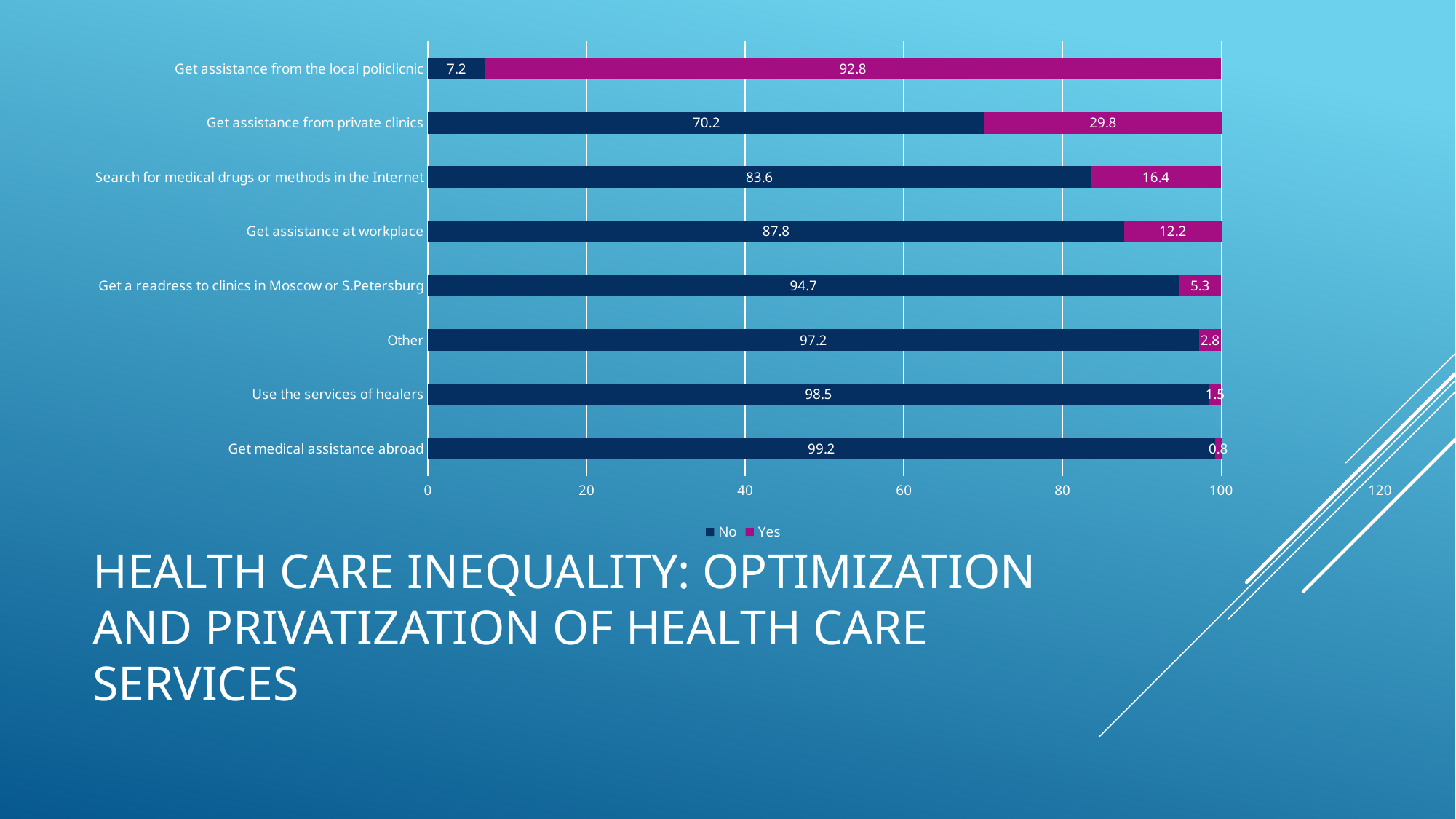
What is the total of the stacked bar for 'Other'? 100 How many series does the legend list? 2 Which category has the highest 'Yes' value? Get assistance from the local policlicnic Which colour represents the 'Yes' series in the legend? Magenta Which category has the lowest 'Yes' value? Get medical assistance abroad Which is larger: the 'Yes' value for 'Get assistance at workplace' or the 'Yes' value for 'Get a readress to clinics in Moscow or S.Petersburg'? Get assistance at workplace How many categories are shown on the chart? 8 What is the 'Yes' value for 'Get assistance from the local policlicnic'? 92.8 What kind of chart is shown on the slide? Stacked bar chart What is the 'No' value for 'Get assistance from private clinics'? 70.2 What is the difference between the 'No' values for 'Get assistance at workplace' and 'Get assistance from private clinics'? 17.6 What is the 'Yes' value for 'Search for medical drugs or methods in the Internet'? 16.4